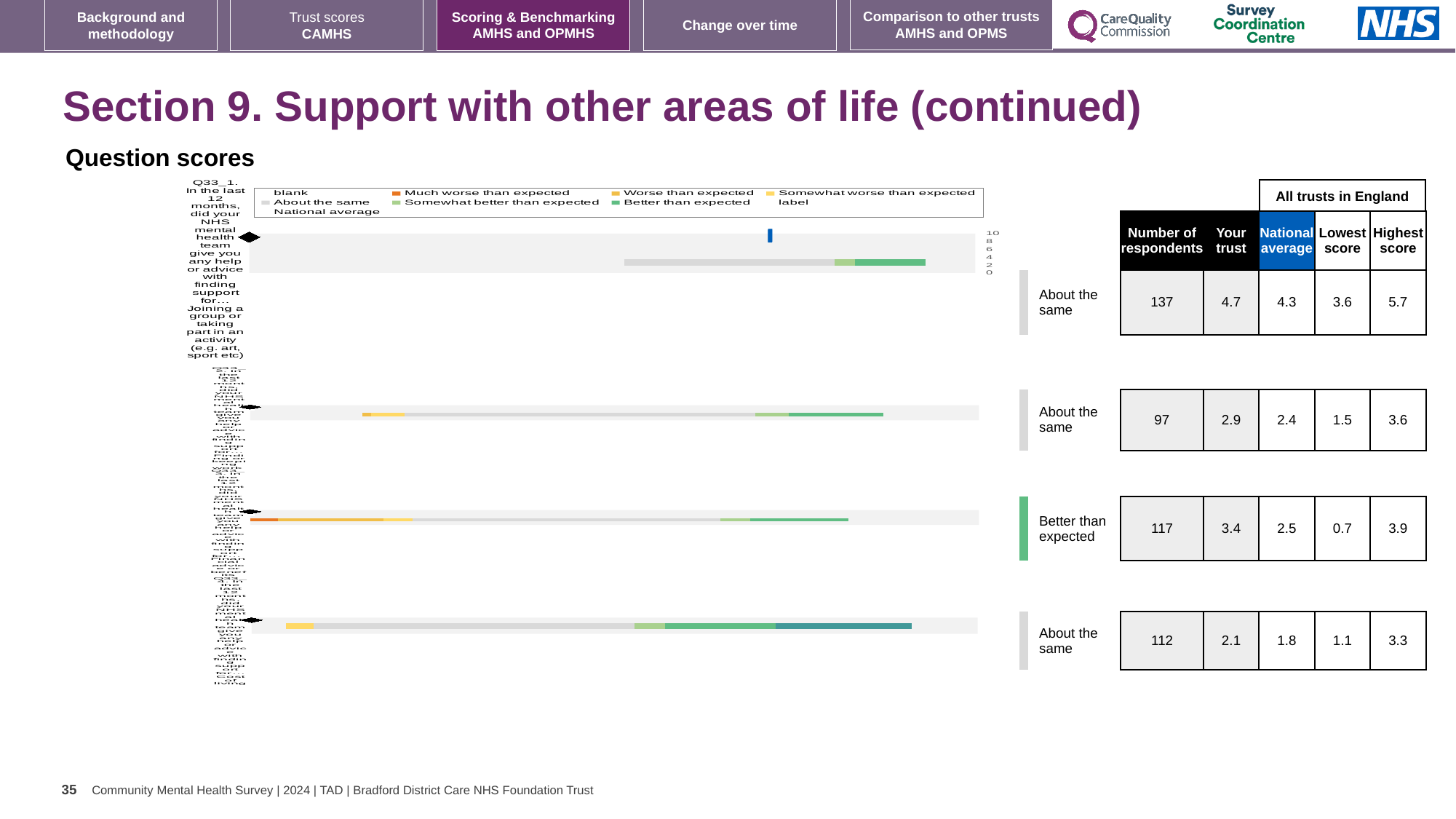
How many bars (question rows) does the chart contain? 4 In the table beside the chart, what is the difference between the 'Your trust' score and the national average for the first row (Q33_1)? 0.4 In the table beside the chart, what is the highest score for the third row? 3.9 Which benchmark category is shown for the third bar from the top? Better than expected What kind of chart is shown on the slide? bar chart In the table beside the chart, which is larger for the first row (Q33_1): the 'Your trust' score or the national average? Your trust In the table beside the chart, what is the number of respondents for the first row (Q33_1)? 137 In the table beside the chart, what is the national average for the first row (Q33_1)? 4.3 In the table beside the chart, what is the 'Your trust' score for the first row (Q33_1)? 4.7 What colour does the legend use for 'Much worse than expected'? orange What is the highest tick value shown on the chart's axis? 10 How many entries does the chart legend list? 9